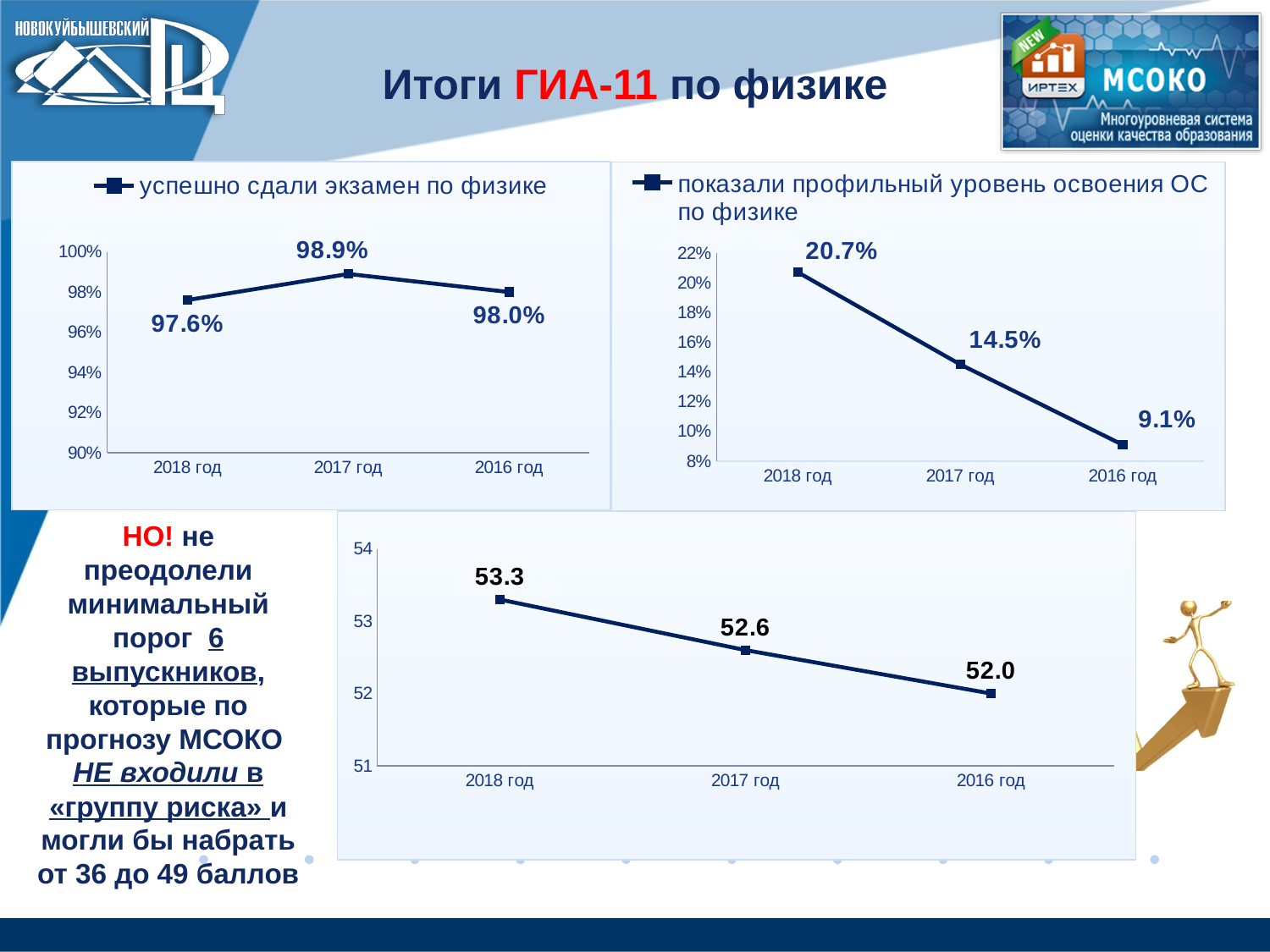
In the top-left chart 'успешно сдали экзамен по физике', what is the value for 2018 год? 97.6% In the top-left chart 'успешно сдали экзамен по физике', what is the difference between the values for 2017 год and 2018 год? 1.3% In the bottom chart, how many data points are plotted? 3 In the top-right chart 'показали профильный уровень освоения ОС по физике', what is the difference between the values for 2018 год and 2016 год? 11.6% How many series does the legend of the top-left chart list? 1 In the top-right chart 'показали профильный уровень освоения ОС по физике', do the values rise or fall moving left to right along the x axis? fall In the top-right chart 'показали профильный уровень освоения ОС по физике', which year has the lowest value? 2016 год In the bottom chart, what is the value for 2016 год? 52.0 What type of chart is the bottom chart? line chart In the top-left chart 'успешно сдали экзамен по физике', which year has the highest value? 2017 год In the top-right chart 'показали профильный уровень освоения ОС по физике', what is the value for 2017 год? 14.5% In the bottom chart, which is larger, the value for 2018 год or the value for 2017 год? 2018 год